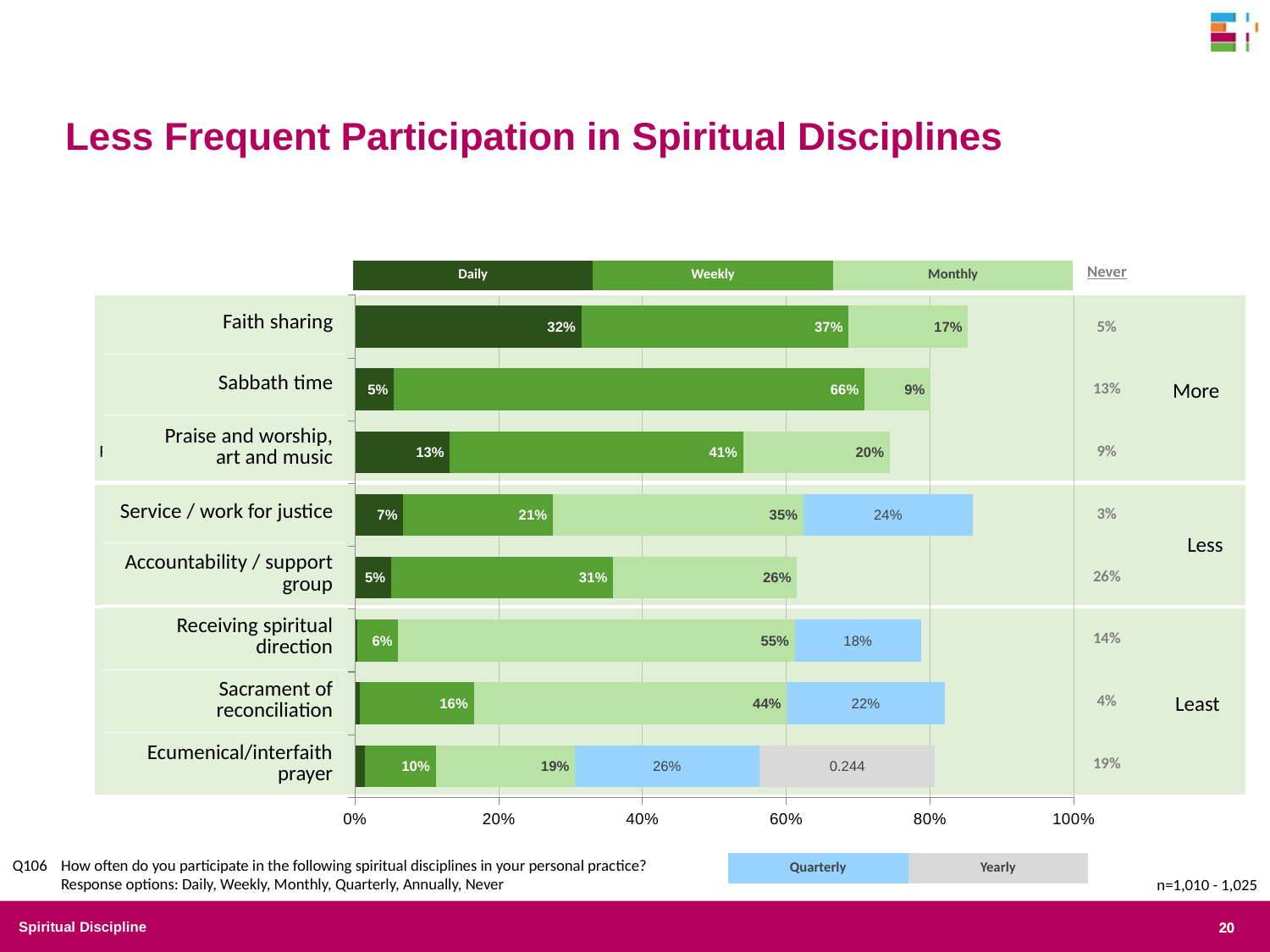
Which is larger: the Daily value for Faith sharing or the Daily value for Praise and worship, art and music? Faith sharing What is the Quarterly value for Ecumenical/interfaith prayer? 26% How many spiritual disciplines (categories) are plotted in the chart? 8 What is the combined total of the Daily, Weekly, Monthly and Quarterly segments for Service / work for justice? 87% What kind of chart is shown on the slide? Stacked bar chart What is the Weekly value for Sabbath time? 66% Which discipline has the lowest Never value? Service / work for justice What is the Monthly value for Receiving spiritual direction? 55% How many series does the chart legend list? 5 For Faith sharing, how much larger is the Weekly value than the Daily value? 5 percentage points Which discipline has the highest Weekly value? Sabbath time What is the Never value for Accountability / support group? 26%